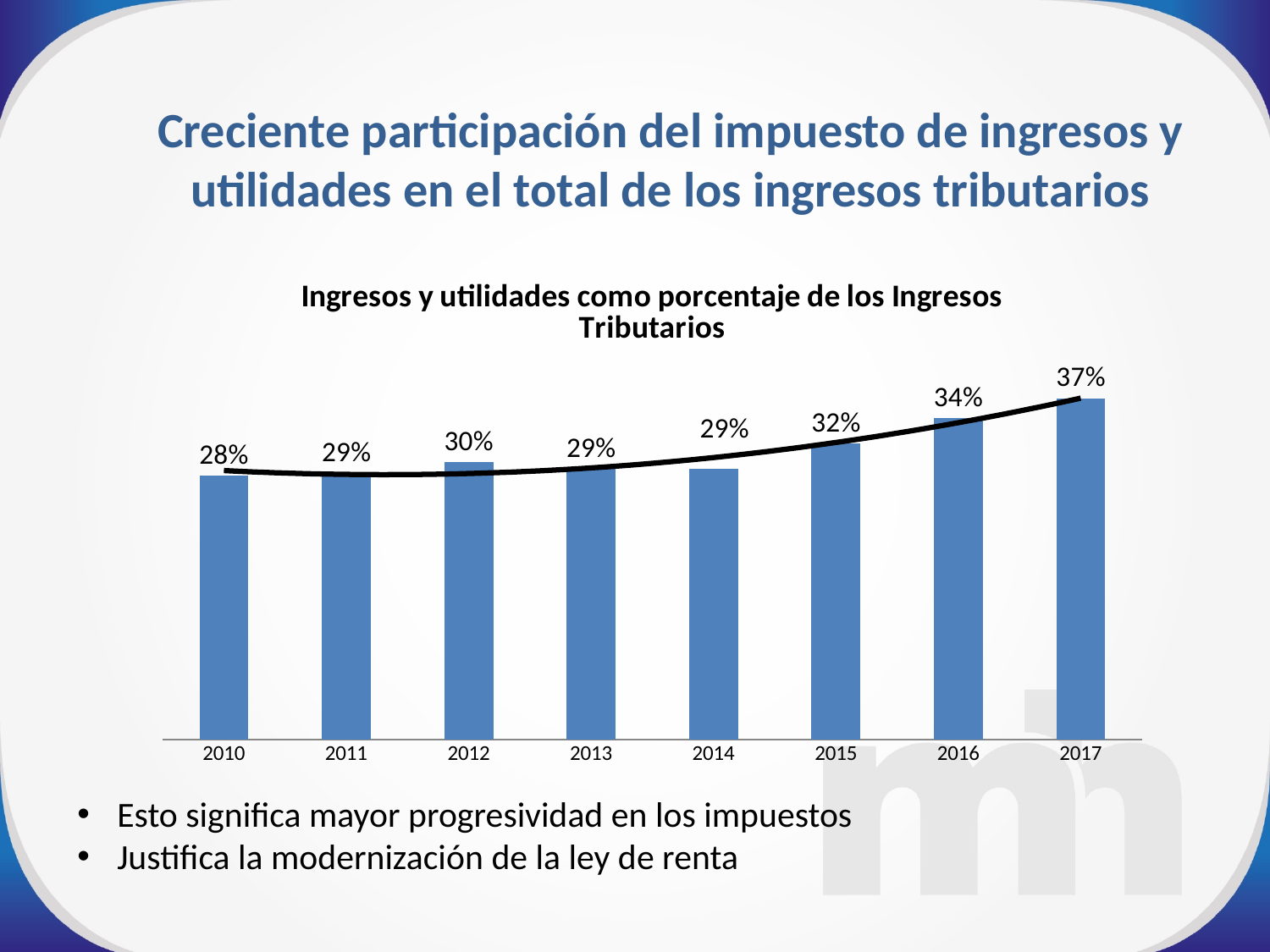
What kind of chart is this? bar chart What is the value for 2010? 28% Which year has the lowest value? 2010 What is the title of the chart? Ingresos y utilidades como porcentaje de los Ingresos Tributarios What is the value for 2015? 32% What is the value for 2012? 30% Which is larger, the value for 2016 or the value for 2014? 2016 How many years are shown on the x axis? 8 What is the value for 2017? 37% What is the difference between the values for 2016 and 2015? 2% What is the difference between the values for 2017 and 2010? 9% Which year has the highest value? 2017